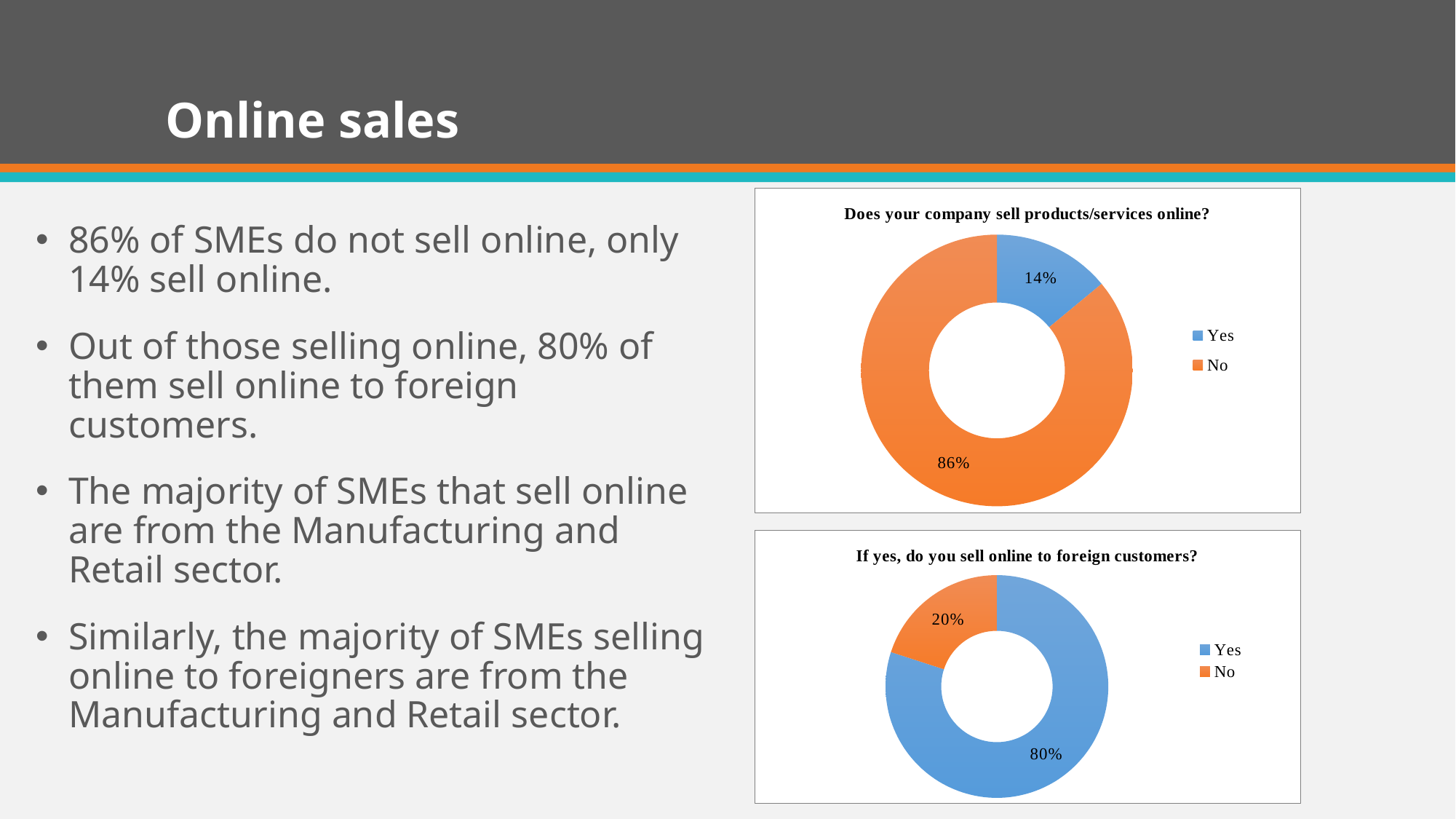
In the chart titled "If yes, do you sell online to foreign customers?", what percentage answered No? 20% What type of chart is used in the chart titled "Does your company sell products/services online?"? Doughnut chart In the top chart, which colour represents the No response? Orange In the top chart, which response has the larger share, Yes or No? No What is the title of the bottom chart? If yes, do you sell online to foreign customers? In the chart titled "If yes, do you sell online to foreign customers?", what percentage answered Yes? 80% In the bottom chart, what is the difference in percentage points between the Yes and No shares? 60 In the chart titled "Does your company sell products/services online?", what percentage answered No? 86% In the bottom chart, which response has the largest share? Yes In the chart titled "Does your company sell products/services online?", what percentage answered Yes? 14% In the top chart, what is the difference in percentage points between the No and Yes shares? 72 How many categories does the legend of the bottom chart list? 2